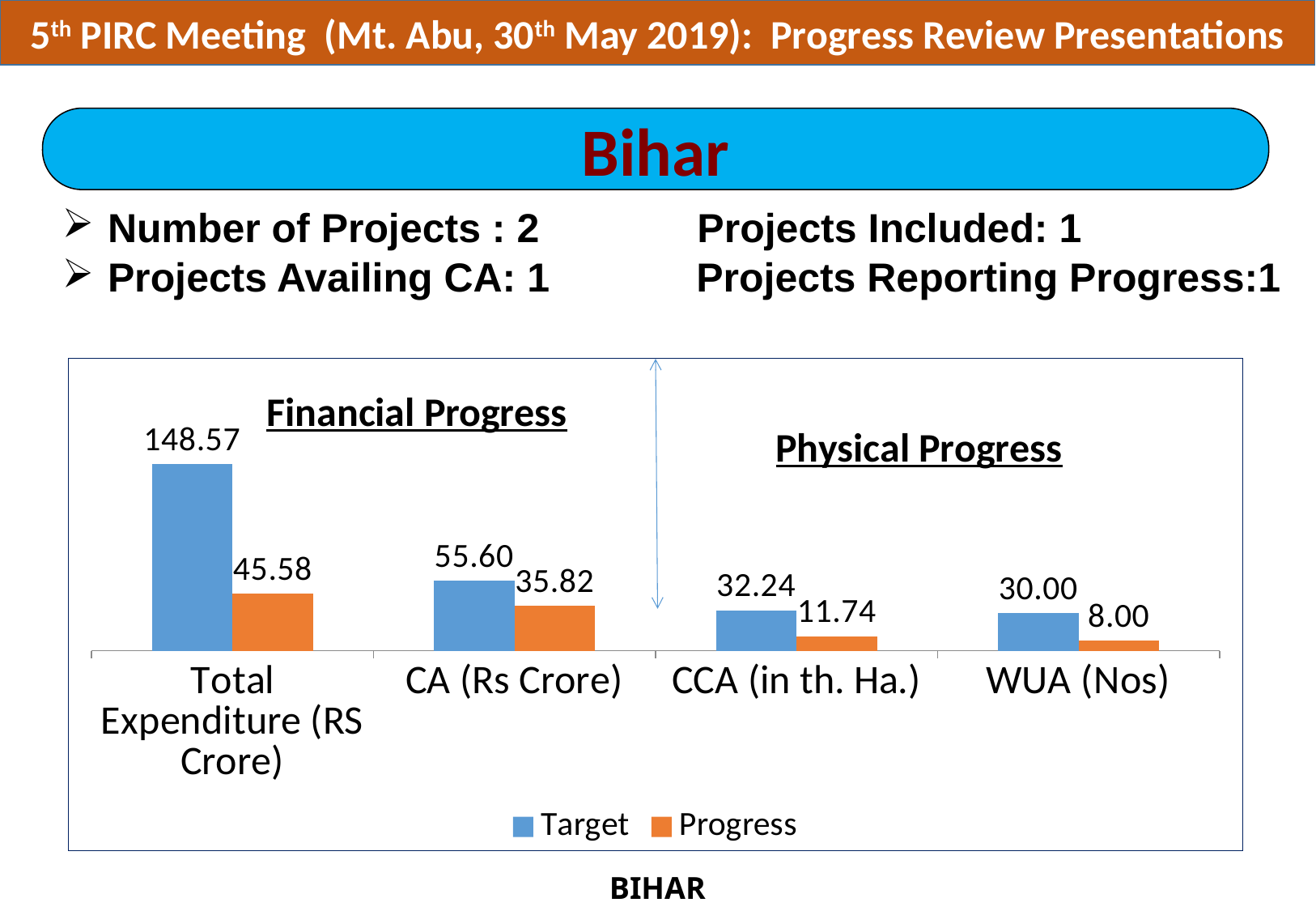
Which category has the lowest Progress value? WUA (Nos) Which is larger, the Progress value for CA (Rs Crore) or the Target value for CCA (in th. Ha.)? Progress value for CA (Rs Crore) How many categories are shown on the x axis? 4 What is the Target value for Total Expenditure (RS Crore)? 148.57 What kind of chart is shown on the slide? Bar chart What is the Target value for CCA (in th. Ha.)? 32.24 Which category has the highest Target value? Total Expenditure (RS Crore) What is the difference between the Target and Progress values for CCA (in th. Ha.)? 20.50 What is the difference between the Target and Progress values for Total Expenditure (RS Crore)? 102.99 What is the Progress value for WUA (Nos)? 8.00 What is the Progress value for CA (Rs Crore)? 35.82 How many series does the legend list? 2